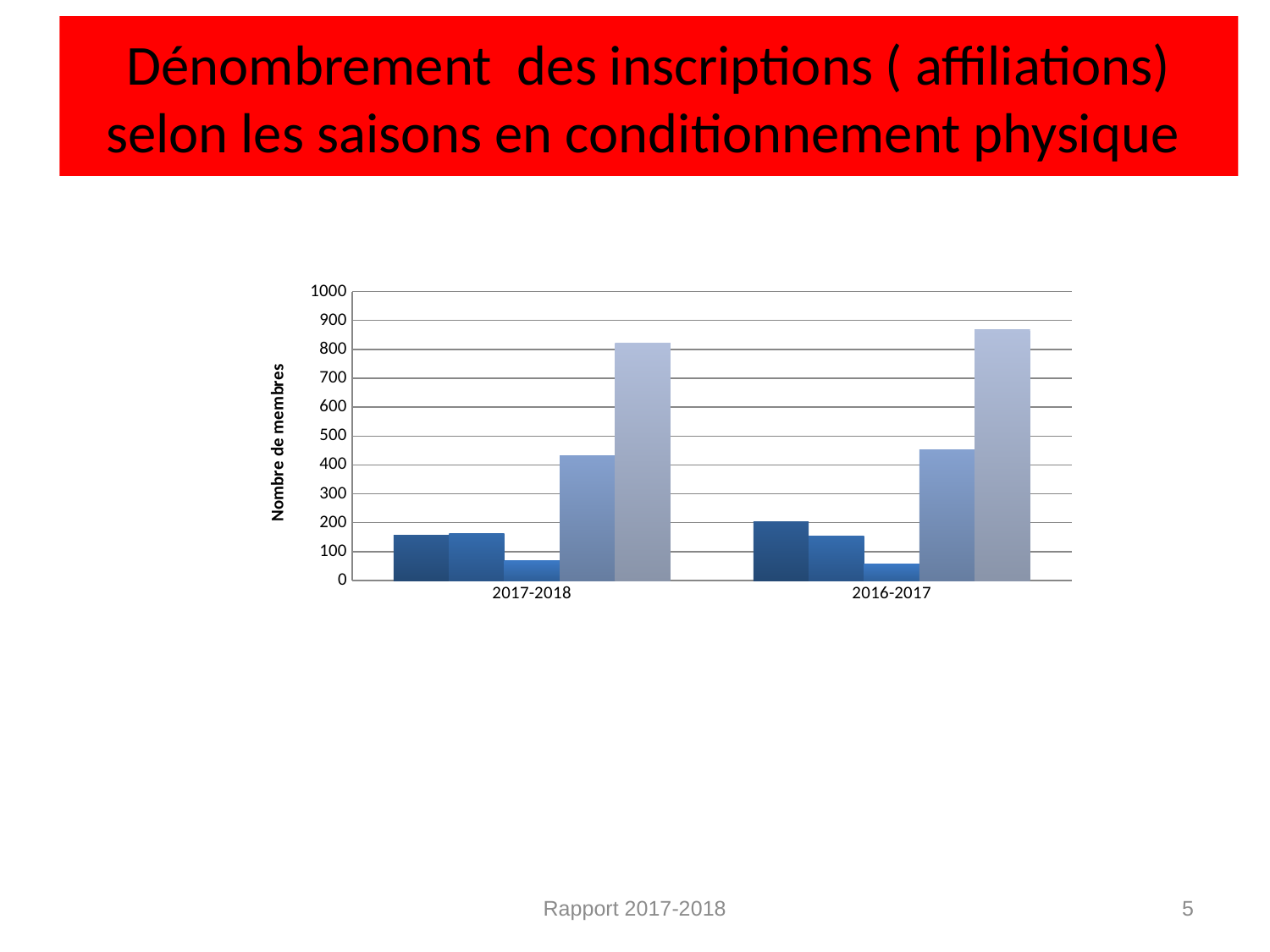
Is the value of the shortest bar for 2016-2017 greater or less than 100? less Which season has the taller tallest bar, 2017-2018 or 2016-2017? 2016-2017 Is the value of the shortest bar for 2017-2018 greater or less than 100? less How many seasons (categories) are shown on the x axis of the chart? 2 Is the value of the tallest bar for 2017-2018 greater or less than 700? greater What kind of chart is shown on the slide? bar chart What is the highest value shown on the vertical axis of the chart? 1000 What is the label of the vertical axis of the chart? Nombre de membres How many bars are plotted for each season in the chart? 5